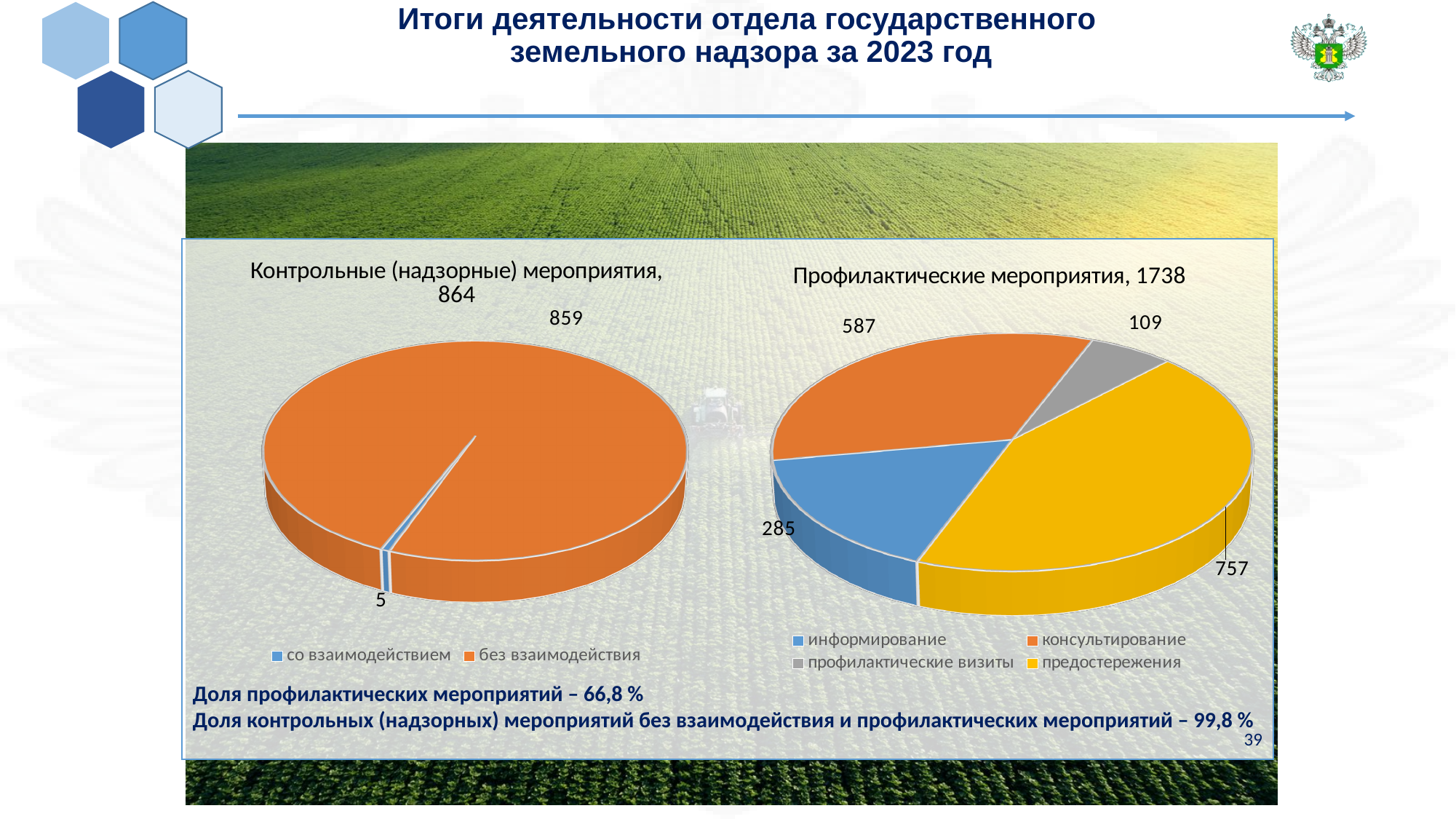
In the chart titled 'Контрольные (надзорные) мероприятия, 864', what is the value for 'со взаимодействием'? 5 In the chart titled 'Профилактические мероприятия, 1738', what is the value for 'информирование'? 285 In the chart titled 'Профилактические мероприятия, 1738', what is the difference between 'предостережения' and 'консультирование'? 170 In the chart titled 'Контрольные (надзорные) мероприятия, 864', what is the difference between 'без взаимодействия' and 'со взаимодействием'? 854 In the chart titled 'Профилактические мероприятия, 1738', what is the value for 'профилактические визиты'? 109 In the chart titled 'Профилактические мероприятия, 1738', which category has the largest slice? предостережения What kind of chart is the chart titled 'Контрольные (надзорные) мероприятия, 864'? pie chart How many categories does the chart titled 'Профилактические мероприятия, 1738' show? 4 In the chart titled 'Профилактические мероприятия, 1738', which category has the smallest slice? профилактические визиты In the chart titled 'Профилактические мероприятия, 1738', what is the value for 'предостережения'? 757 In the chart titled 'Контрольные (надзорные) мероприятия, 864', what is the value for 'без взаимодействия'? 859 In the chart titled 'Профилактические мероприятия, 1738', which is larger: 'консультирование' or 'информирование'? консультирование